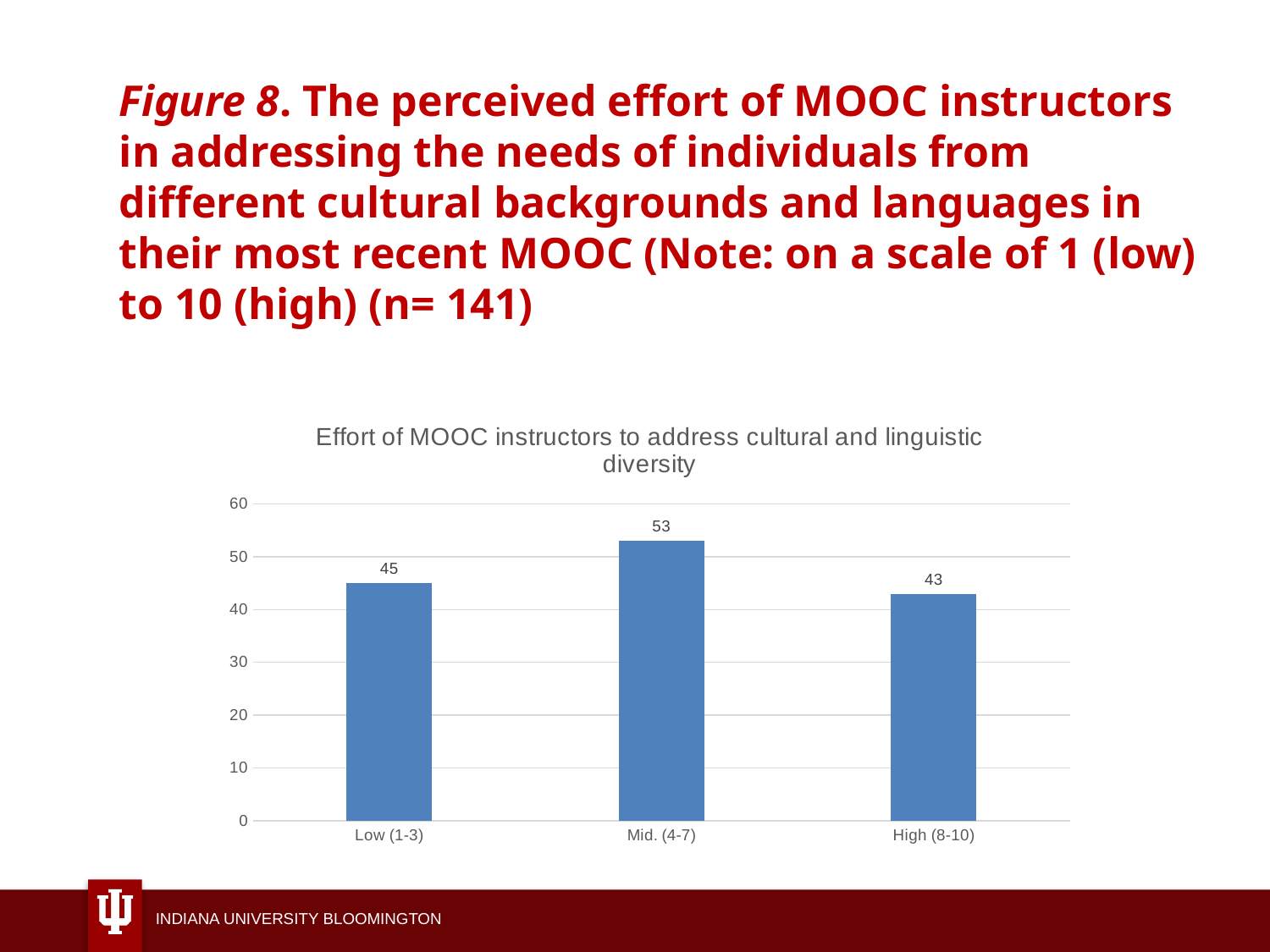
What is the difference between the values for Mid. (4-7) and High (8-10)? 10 What is the difference between the values for Low (1-3) and High (8-10)? 2 What is the value for High (8-10)? 43 How many categories are shown on the x axis? 3 What is the value for Mid. (4-7)? 53 Is the value for Mid. (4-7) greater or less than 50? greater Which is larger, the value for Low (1-3) or the value for Mid. (4-7)? Mid. (4-7) Which category has the highest value? Mid. (4-7) What is the value for Low (1-3)? 45 Which category has the lowest value? High (8-10) What kind of chart is shown on the slide? bar chart What is the title of the chart? Effort of MOOC instructors to address cultural and linguistic diversity